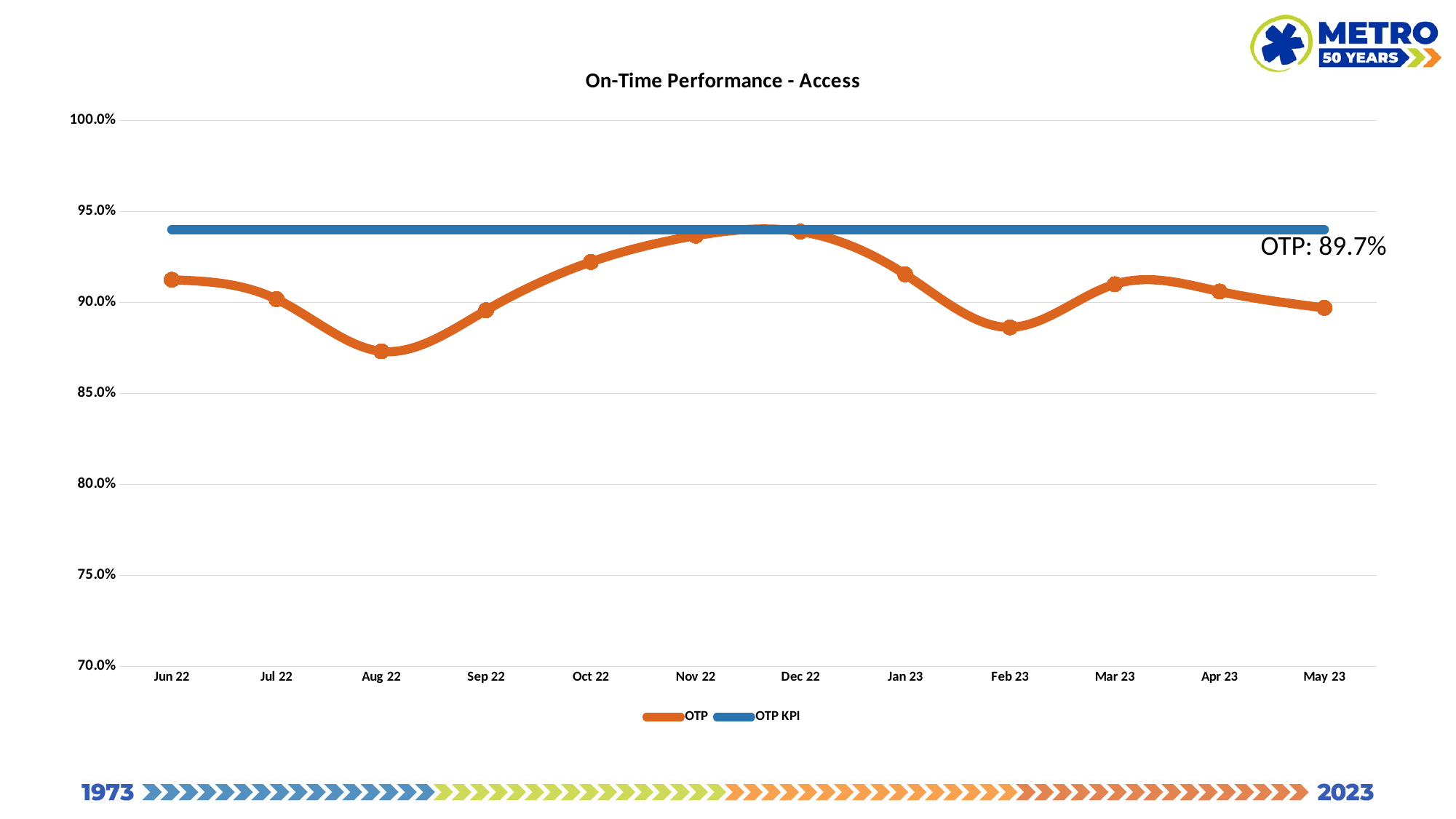
How many months are plotted along the x axis? 12 What OTP value is printed on the chart for May 23? 89.7% What is the title of the chart? On-Time Performance - Access Which month has the lowest OTP value? Aug 22 Does the OTP line rise or fall from Aug 22 to Dec 22? rise Which is larger, the OTP value for Jun 22 or for Aug 22? Jun 22 Is the OTP value for Oct 22 greater or less than 90.0%? greater Is the OTP KPI line greater or less than 95.0%? less How many series does the legend list? 2 Is the OTP value for Aug 22 greater or less than 90.0%? less What are the two entries in the legend? OTP and OTP KPI What kind of chart is shown on the slide? line chart